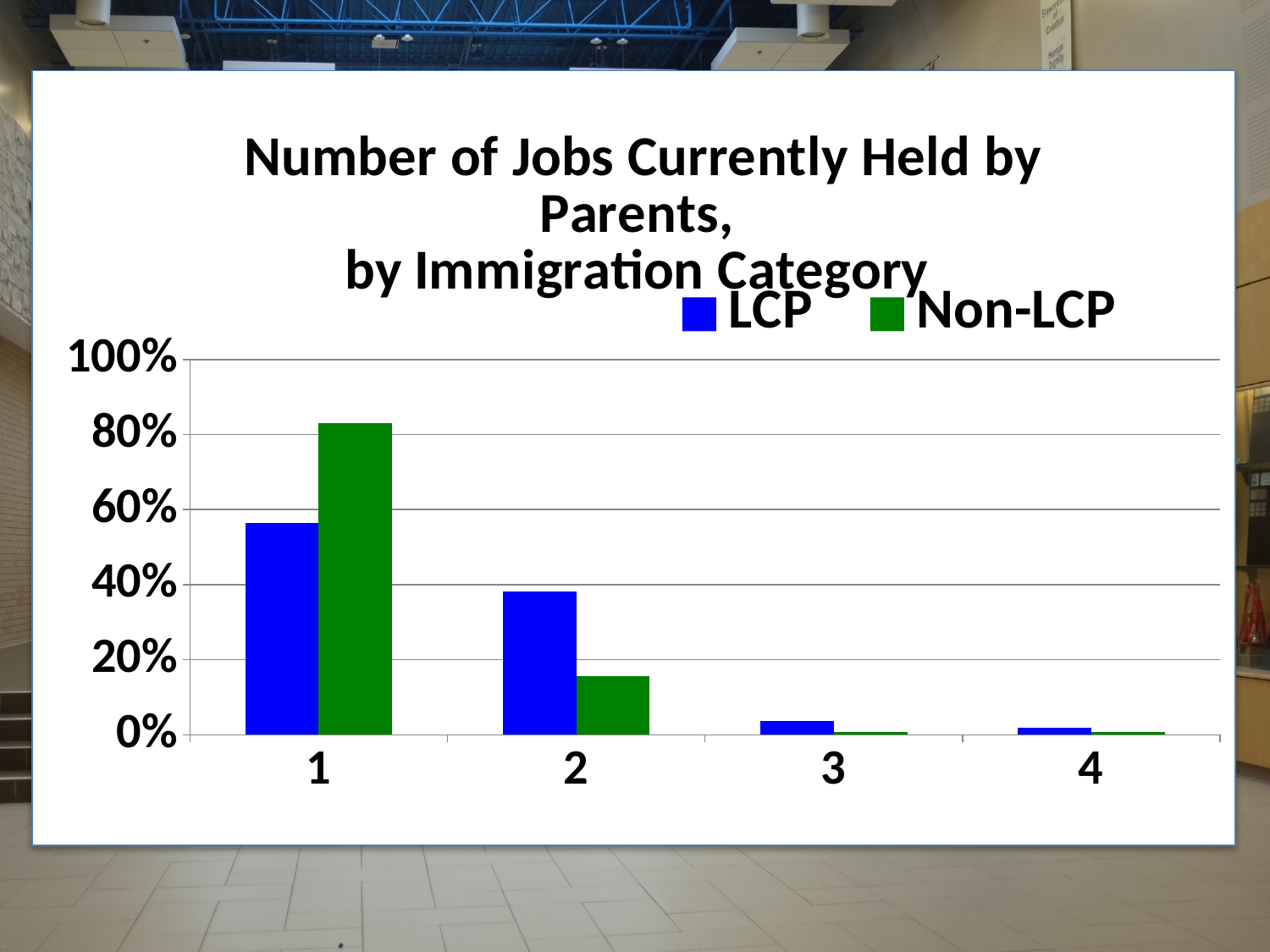
What kind of chart is shown on the slide? bar chart Do the LCP values rise or fall as the number of jobs increases from 1 to 4? fall For 2 jobs, which series has the larger value, LCP or Non-LCP? LCP For 1 job, which series has the larger value, LCP or Non-LCP? Non-LCP For which number of jobs is the LCP value highest? 1 Is the Non-LCP value for 2 jobs greater or less than 20%? less Is the LCP value for 1 job greater or less than 60%? less For which number of jobs is the Non-LCP value highest? 1 Is the Non-LCP value for 1 job greater or less than 80%? greater Which colour represents the Non-LCP series? green How many categories are shown on the x axis? 4 How many series does the legend list? 2